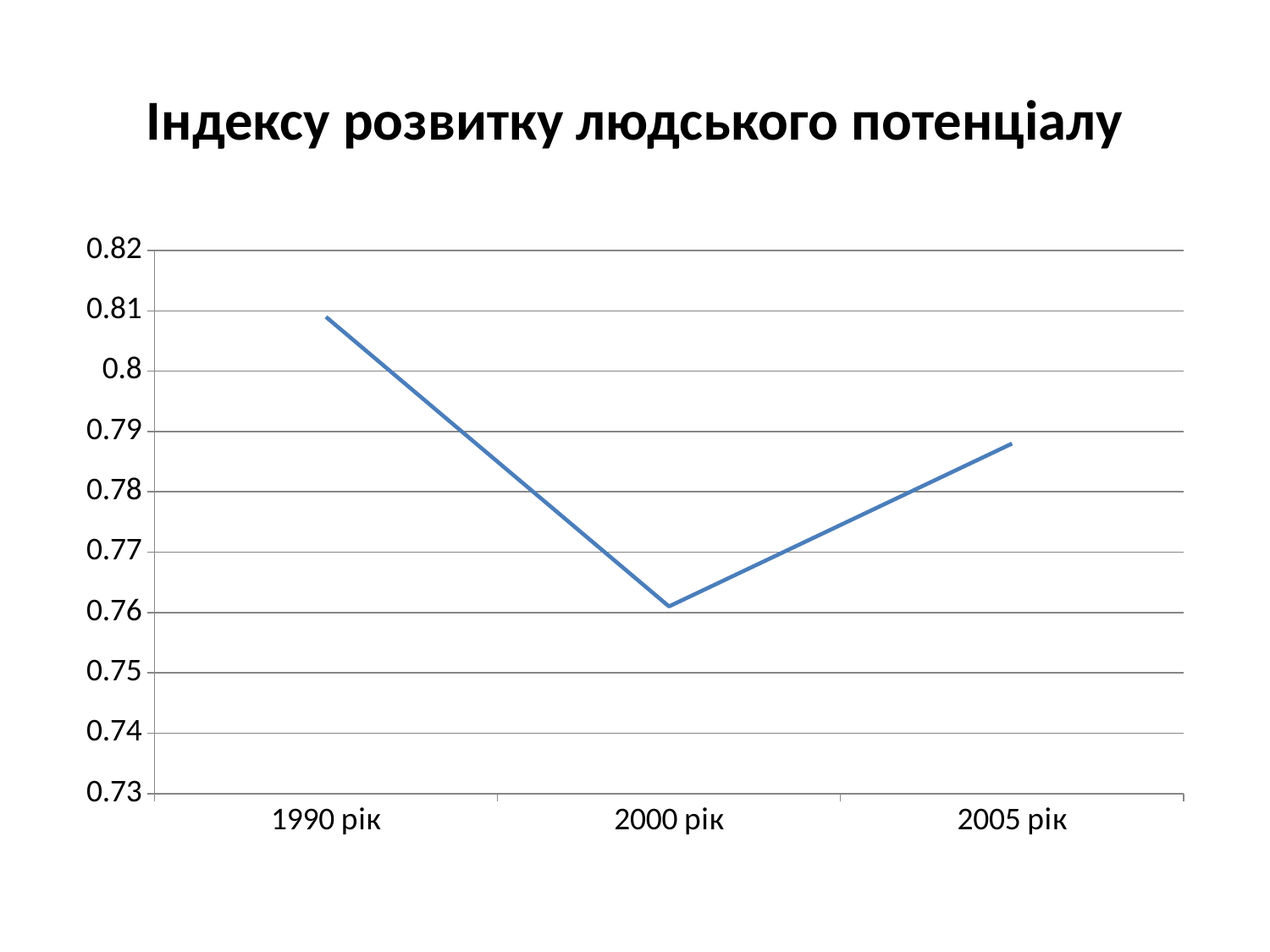
Which is larger, the value for 2000 рік or the value for 2005 рік? 2005 рік Is the value for 2000 рік greater or less than 0.77? less Which is larger, the value for 1990 рік or the value for 2005 рік? 1990 рік What is the title of the chart? Індексу розвитку людського потенціалу How does the value change from 2000 рік to 2005 рік? it rises Which year has the lowest value on the chart? 2000 рік What kind of chart is shown on the slide? line chart How does the value change from 1990 рік to 2000 рік? it falls Is the value for 2005 рік greater or less than 0.78? greater How many points (years) are plotted on the chart? 3 Is the value for 1990 рік greater or less than 0.8? greater Which year has the highest value on the chart? 1990 рік